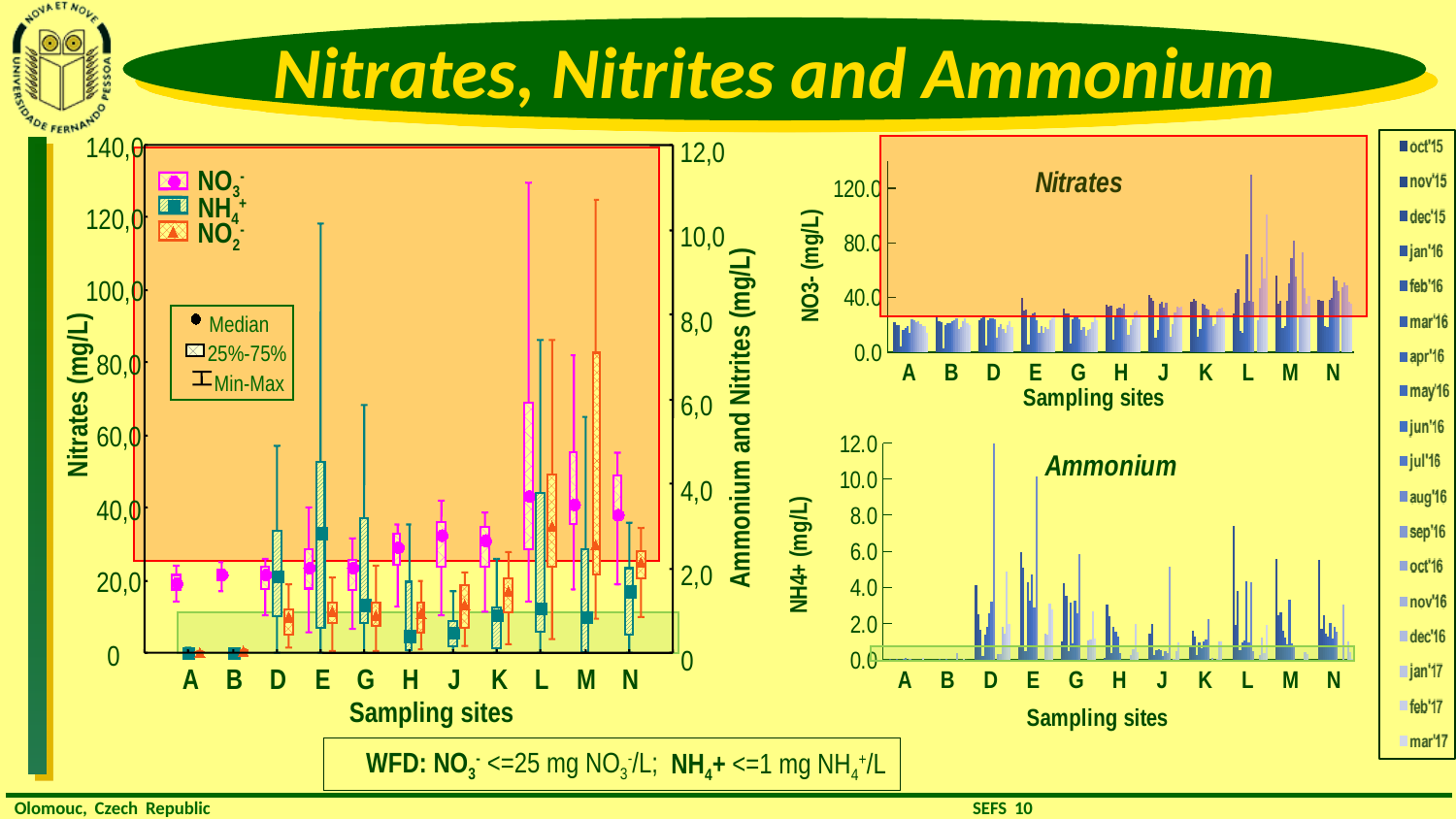
In the left box-plot chart, is the NO3- median for site L greater or less than 20,0 mg/L? greater In the 'Ammonium' chart, is the tallest bar at site D greater or less than 10.0 mg/L? greater How many sampling sites are shown on the x axis of the 'Ammonium' chart? 11 In the left box-plot chart, is the NO3- median for site A greater or less than 40,0 mg/L? less According to the WFD note at the bottom of the slide, what is the limit for NH4+? <=1 mg NH4+/L What kind of chart is the 'Nitrates' chart on the right side of the slide? bar chart In the left box-plot chart, which site has the larger NO3- median, site A or site L? L How many series does the legend of the left box-plot chart list? 3 How many month entries does the legend on the far right of the slide list for the 'Nitrates' and 'Ammonium' charts? 18 In the 'Ammonium' chart, which site has taller bars, site B or site D? D What is the label of the left y axis of the box-plot chart? Nitrates (mg/L)